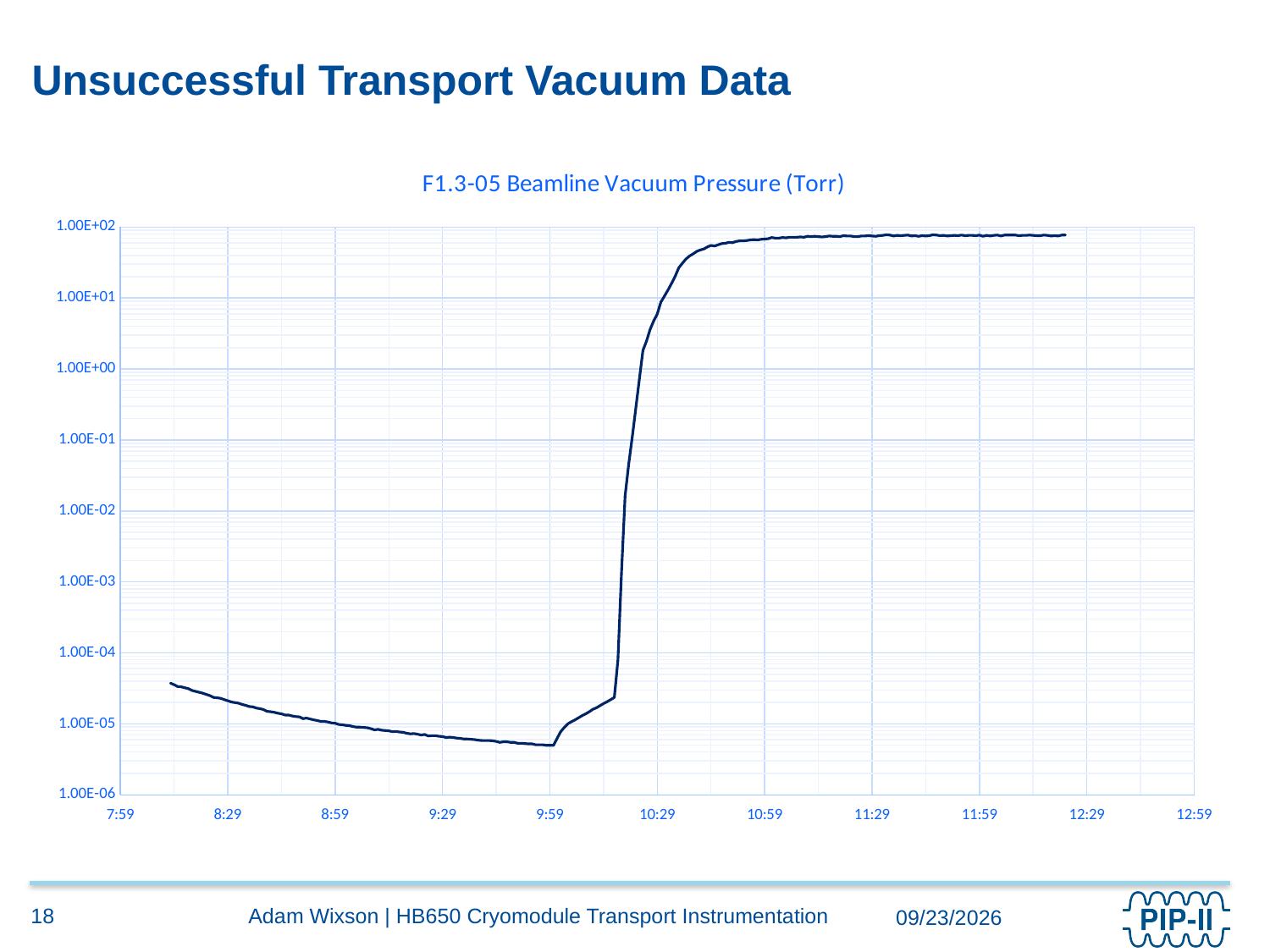
Between 8:29 and 9:59, does the pressure rise or fall? Fall What kind of chart is shown on the slide? Line chart Is the pressure value at 10:59 greater or less than 1.00E+00? greater What is the title of the chart? F1.3-05 Beamline Vacuum Pressure (Torr) Which time has the higher pressure, 8:29 or 9:29? 8:29 Is the pressure value at 8:29 greater or less than 1.00E-04? less How many data series are plotted on the chart? 1 Which time has the higher pressure, 9:59 or 11:59? 11:59 Is the y axis of the chart on a linear or a logarithmic scale? Logarithmic Between 10:29 and 11:29, does the pressure rise or fall? Rise Is the pressure value at 9:59 greater or less than 1.00E-05? less